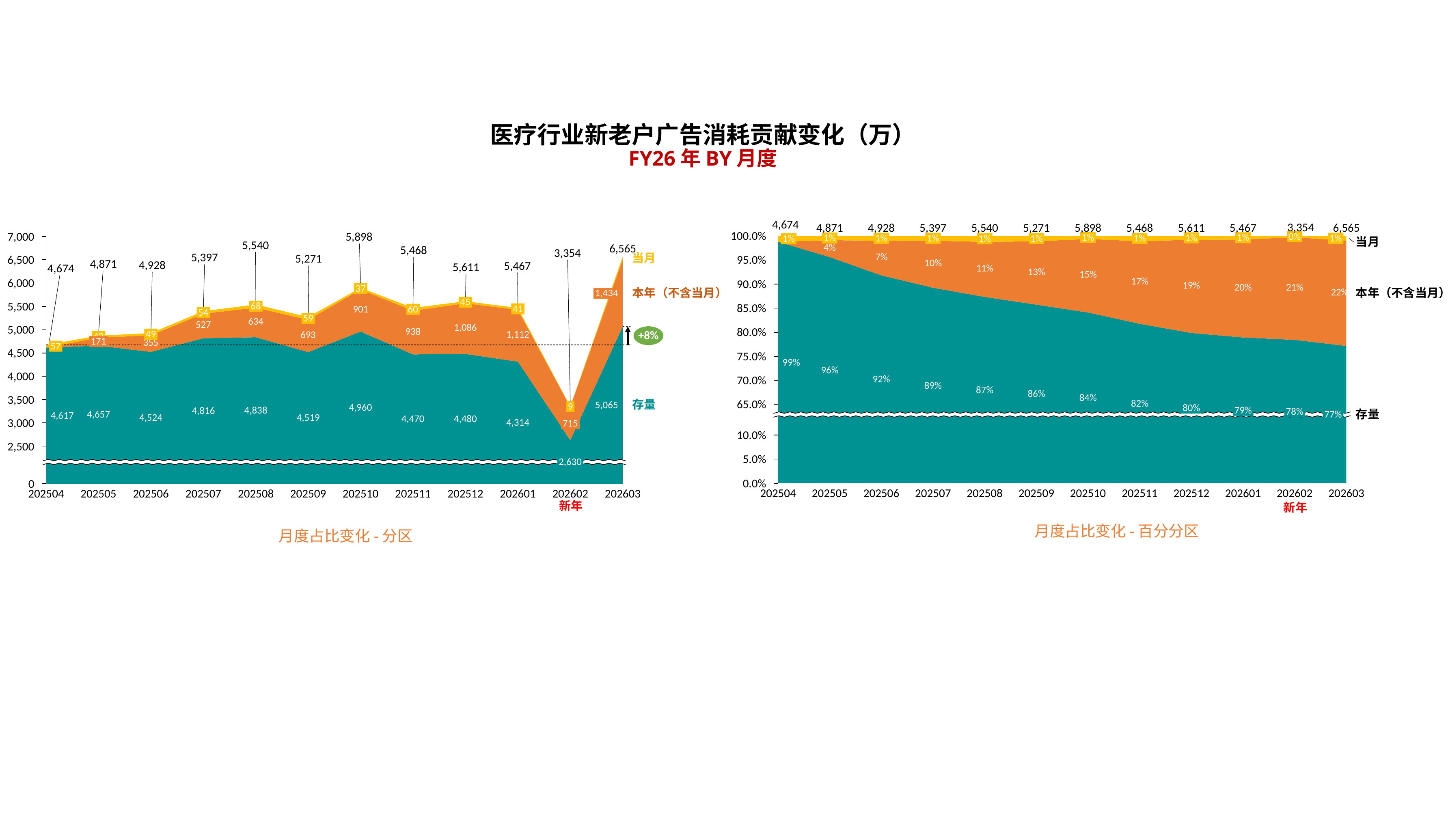
In the left chart (月度占比变化 - 分区), which month has the highest total value? 202603 In the left chart (月度占比变化 - 分区), what is the 存量 value for 202603? 5,065 In the left chart (月度占比变化 - 分区), how many months are shown on the x axis? 12 In the left chart (月度占比变化 - 分区), which month has the lowest total value? 202602 In the right chart (月度占比变化 - 百分分区), what is the 存量 share for 202512? 80% In the right chart (月度占比变化 - 百分分区), what is the 本年（不含当月） share for 202603? 22% In the left chart (月度占比变化 - 分区), what is the total value for 202510? 5,898 In the left chart (月度占比变化 - 分区), what is the 本年（不含当月） value for 202512? 1,086 What type of chart is the right chart (月度占比变化 - 百分分区)? stacked area chart In the left chart (月度占比变化 - 分区), which is larger, the 存量 value for 202507 or for 202508? 202508 In the left chart (月度占比变化 - 分区), what is the difference between the total for 202603 and the total for 202602? 3,211 In the right chart (月度占比变化 - 百分分区), does the 存量 share rise or fall from 202504 to 202603? fall